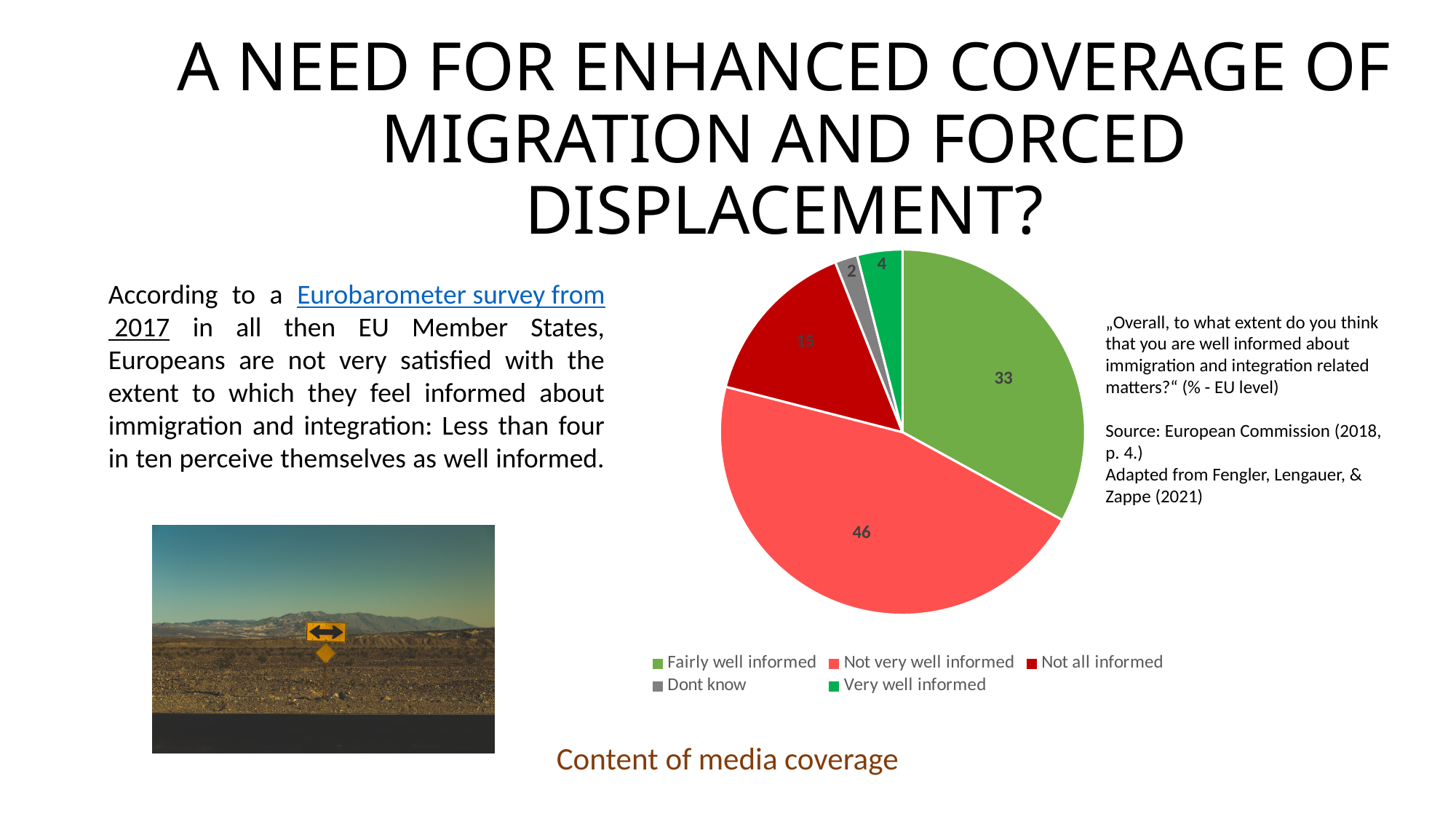
Which is larger, the "Very well informed" slice or the "Dont know" slice? Very well informed What value is shown for the "Dont know" slice? 2 How many categories does the pie chart have? 5 What kind of chart is shown on the slide? pie chart What is the combined value of the "Fairly well informed" and "Very well informed" slices? 37 Which category has the smallest slice of the pie? Dont know What value is shown for the "Fairly well informed" slice? 33 What is the difference between the "Not very well informed" and "Fairly well informed" values? 13 What colour is the "Not all informed" slice in the pie chart? dark red Which category has the largest slice of the pie? Not very well informed What value is shown for the "Not very well informed" slice? 46 What value is shown for the "Very well informed" slice? 4